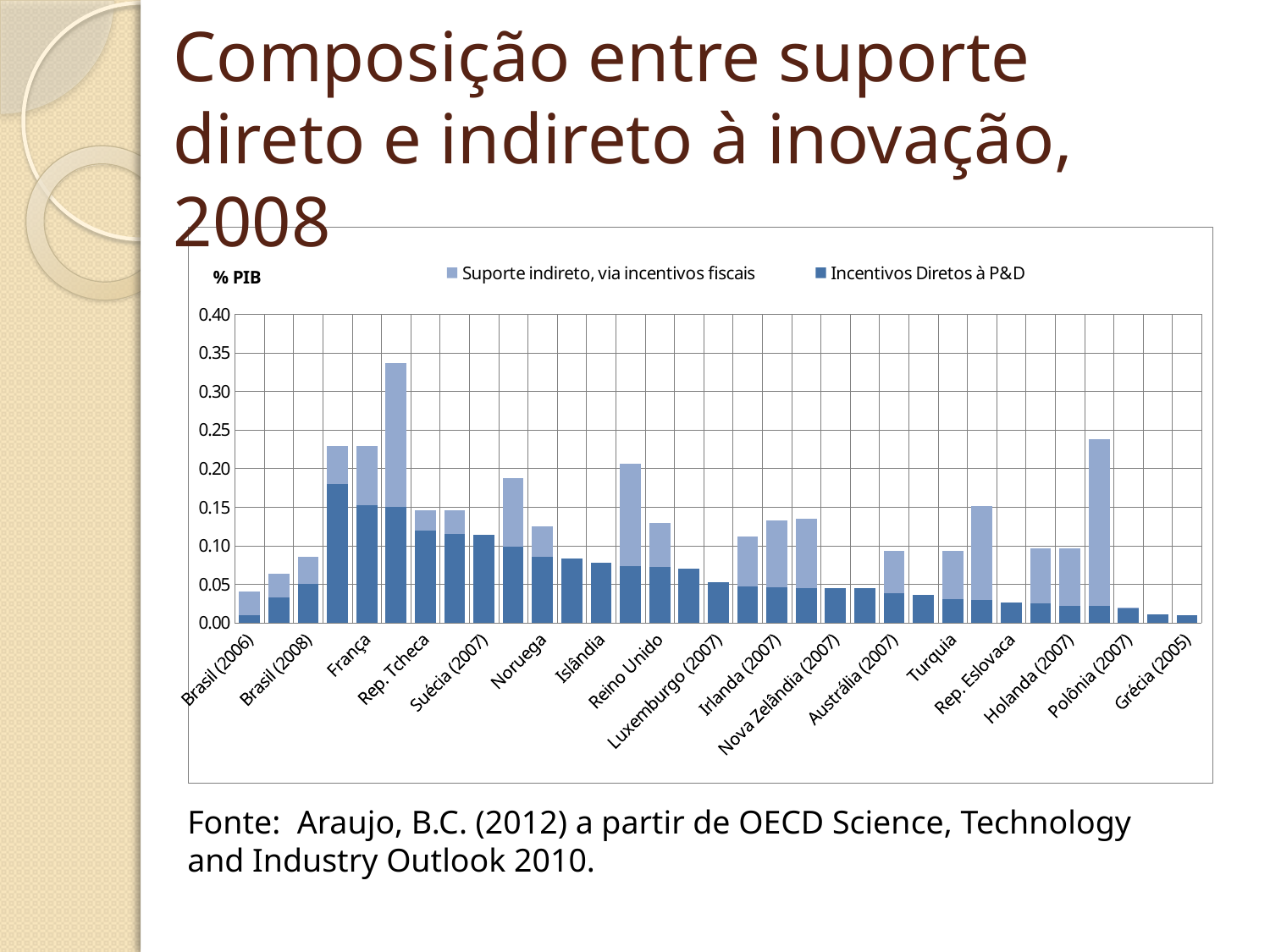
Is the total value for Nova Zelândia (2007) greater or less than 0.10? less Which has the larger total value, Brasil (2008) or Brasil (2006)? Brasil (2008) Is the total value for Brasil (2006) greater or less than 0.10? less What kind of chart is shown on the slide? Stacked bar chart What unit label is shown at the top of the vertical axis? % PIB Which has the larger total value, França or Brasil (2008)? França Is the total value for Rep. Tcheca greater or less than 0.20? less What are the two series named in the chart legend? Suporte indireto, via incentivos fiscais; Incentivos Diretos à P&D How many series does the chart legend list? 2